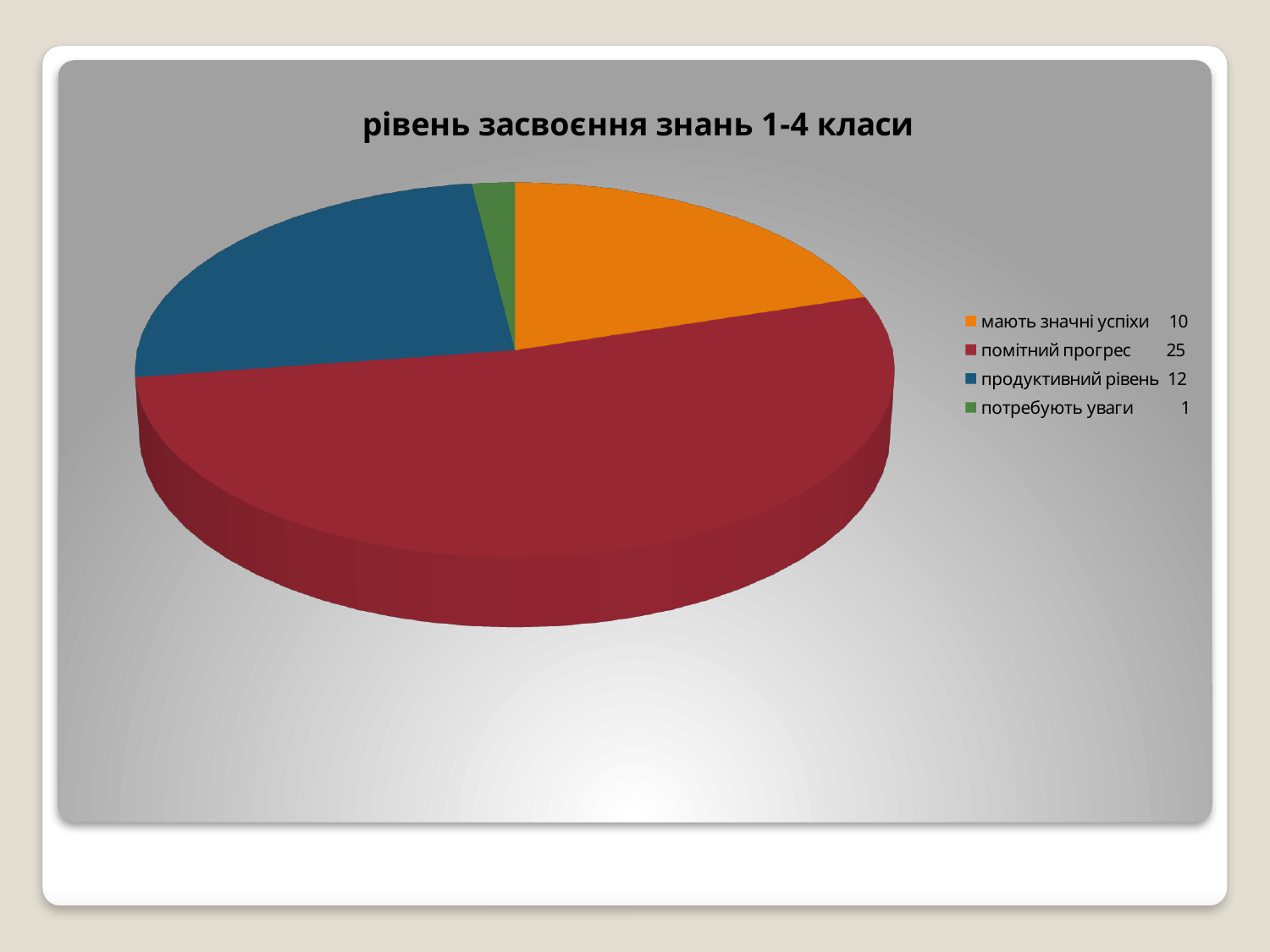
Which is larger, the value for "продуктивний рівень" or the value for "мають значні успіхи"? продуктивний рівень What is the value for "потребують уваги"? 1 What type of chart is shown on the slide? pie chart How many categories does the pie chart have? 4 What share of the pie does "продуктивний рівень" represent? 25% What is the value for "мають значні успіхи"? 10 What is the value for "продуктивний рівень"? 12 What is the title of the chart? рівень засвоєння знань 1-4 класи What is the difference between the values for "помітний прогрес" and "продуктивний рівень"? 13 Which category has the largest slice of the pie? помітний прогрес What is the value for "помітний прогрес"? 25 Which category has the smallest slice of the pie? потребують уваги